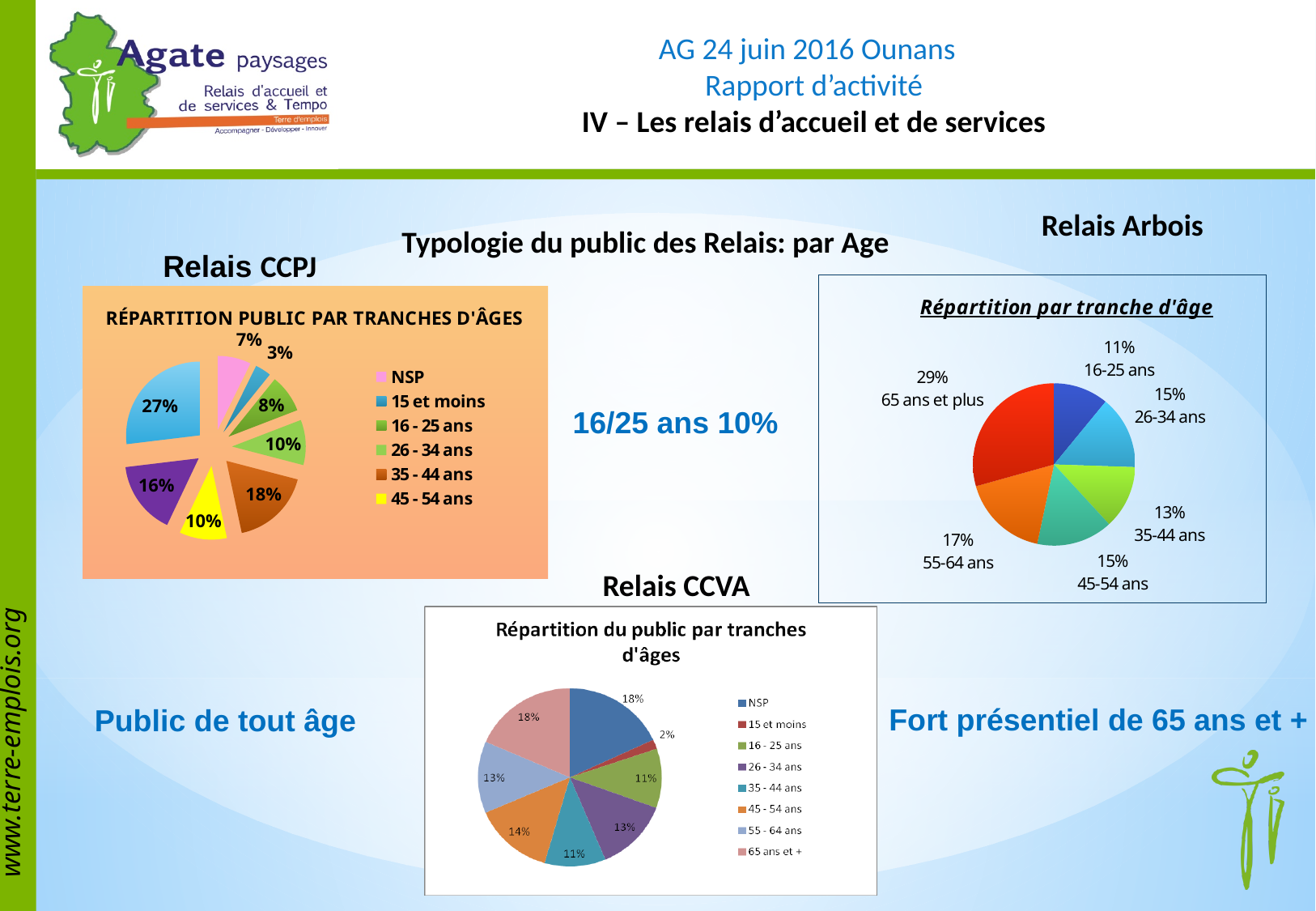
How many entries does the legend of the Relais CCVA chart list? 8 In the Relais CCPJ chart, which is larger: the share for 16 - 25 ans or the share for 26 - 34 ans? 26 - 34 ans In the Relais Arbois chart, which age group has the smallest share? 16-25 ans In the Relais Arbois chart, what share of the public is 65 ans et plus? 29% In the Relais CCVA chart, what share of the public is 15 et moins? 2% In the Relais Arbois chart, which age group has the largest share? 65 ans et plus What type of chart is used for the Relais CCVA data? Pie chart In the Relais CCVA chart, what share of the public is 45 - 54 ans? 14% In the Relais CCPJ chart, what share is labelled for 15 et moins? 3% In the Relais Arbois chart, what is the difference between the 55-64 ans share and the 35-44 ans share? 4% In the Relais CCPJ chart, what share is labelled for 35 - 44 ans? 18% How many slices does the Relais Arbois pie chart have? 6